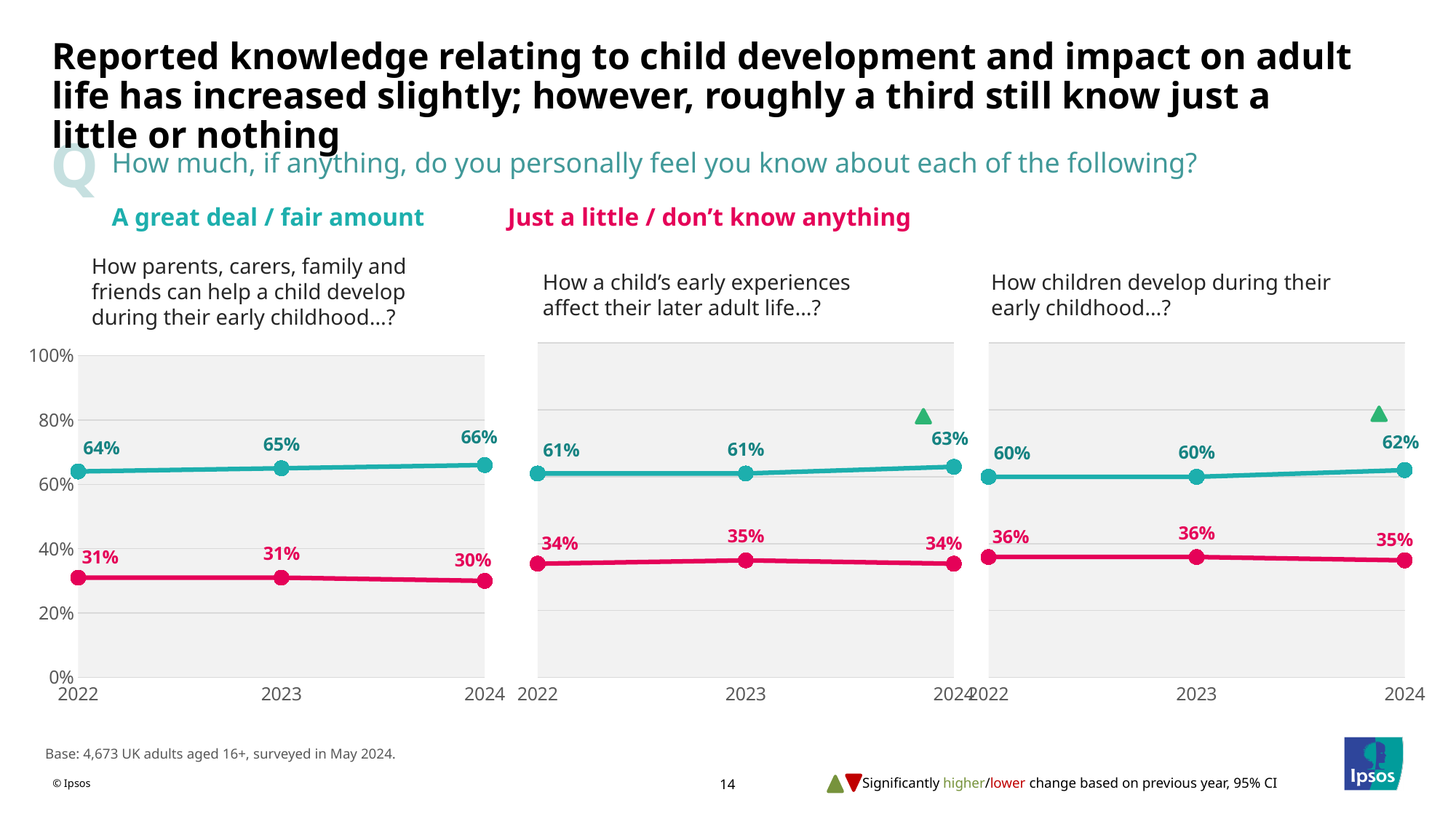
What kind of chart is the middle chart ('How a child's early experiences affect their later adult life...?')? line chart In the right chart ('How children develop during their early childhood...?'), is the 'A great deal / fair amount' value in 2024 greater or less than 60%? greater In the left chart ('How parents, carers, family and friends can help a child develop during their early childhood...?'), which year has the lowest 'Just a little / don't know anything' value? 2024 In the right chart ('How children develop during their early childhood...?'), what is the value for 'A great deal / fair amount' in 2022? 60% In the middle chart ('How a child's early experiences affect their later adult life...?'), which year has the highest 'A great deal / fair amount' value? 2024 Which colour represents the 'Just a little / don't know anything' series in the charts? pink In the right chart ('How children develop during their early childhood...?'), what is the value for 'Just a little / don't know anything' in 2024? 35% In the left chart ('How parents, carers, family and friends can help a child develop during their early childhood...?'), what is the difference between the 'A great deal / fair amount' and 'Just a little / don't know anything' values in 2024? 36 percentage points In the middle chart ('How a child's early experiences affect their later adult life...?'), does the 'A great deal / fair amount' series rise or fall from 2023 to 2024? rise In the middle chart ('How a child's early experiences affect their later adult life...?'), what is the value for 'Just a little / don't know anything' in 2023? 35% In the left chart ('How parents, carers, family and friends can help a child develop during their early childhood...?'), what is the value for 'A great deal / fair amount' in 2024? 66% How many years are plotted on the x axis of the left chart ('How parents, carers, family and friends can help a child develop during their early childhood...?')? 3